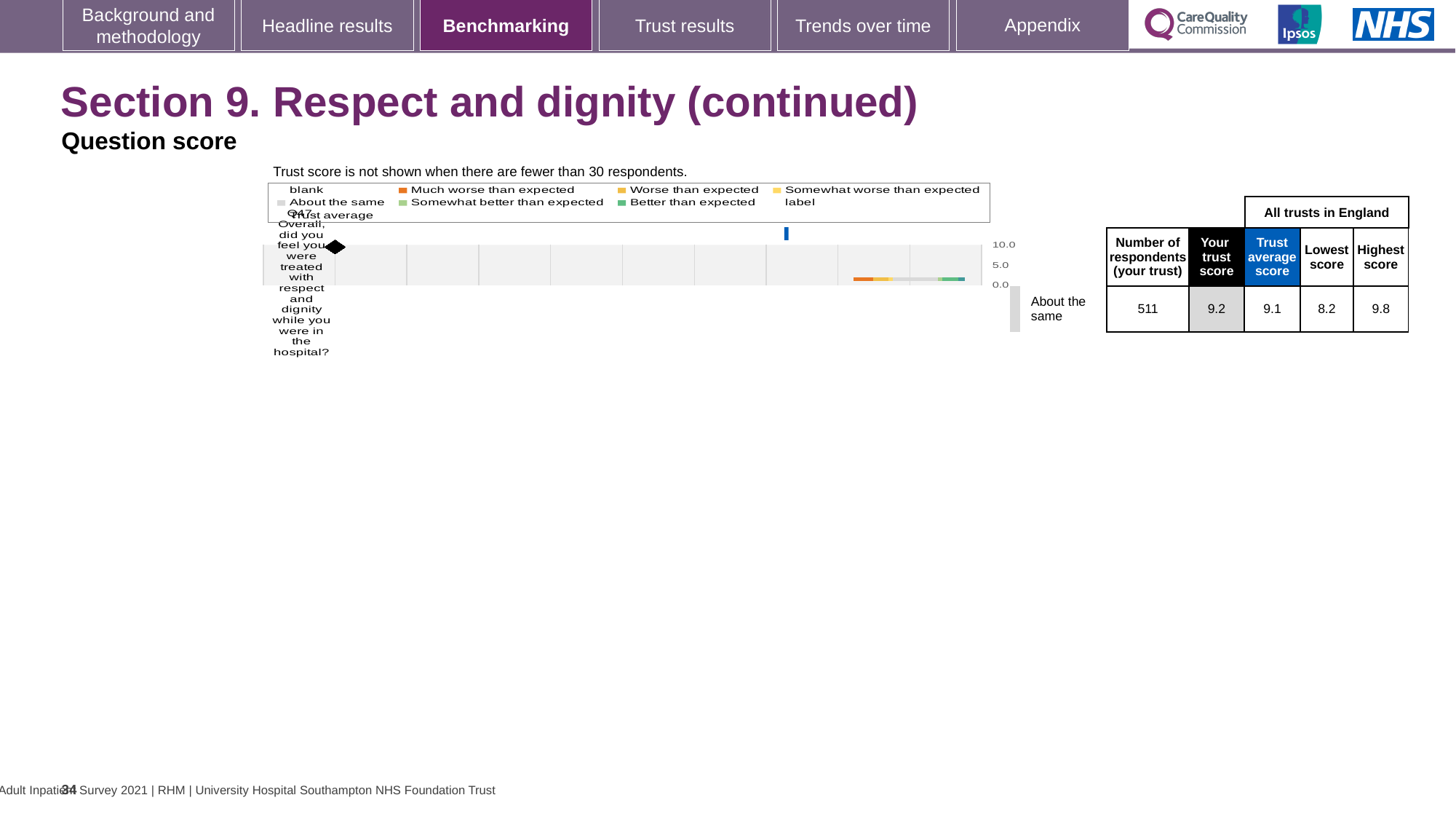
In the table beside the chart, what is the lowest score among all trusts in England? 8.2 In the table beside the chart, which is larger: your trust score or the trust average score? Your trust score What question number is labelled on the chart's category axis? Q47 In the table beside the chart, what is the highest score among all trusts in England? 9.8 In the table beside the chart, what is your trust score for Q47? 9.2 How many question categories are plotted on the chart? 1 In the table beside the chart, what is the trust average score for all trusts in England? 9.1 In the table beside the chart, what is the difference between the highest score and the lowest score? 1.6 What type of chart is shown on the slide? bar chart In the table beside the chart, what is the number of respondents for your trust? 511 What is the highest tick value shown on the chart's numeric axis? 10.0 What benchmark category label is shown next to the chart for Q47? About the same